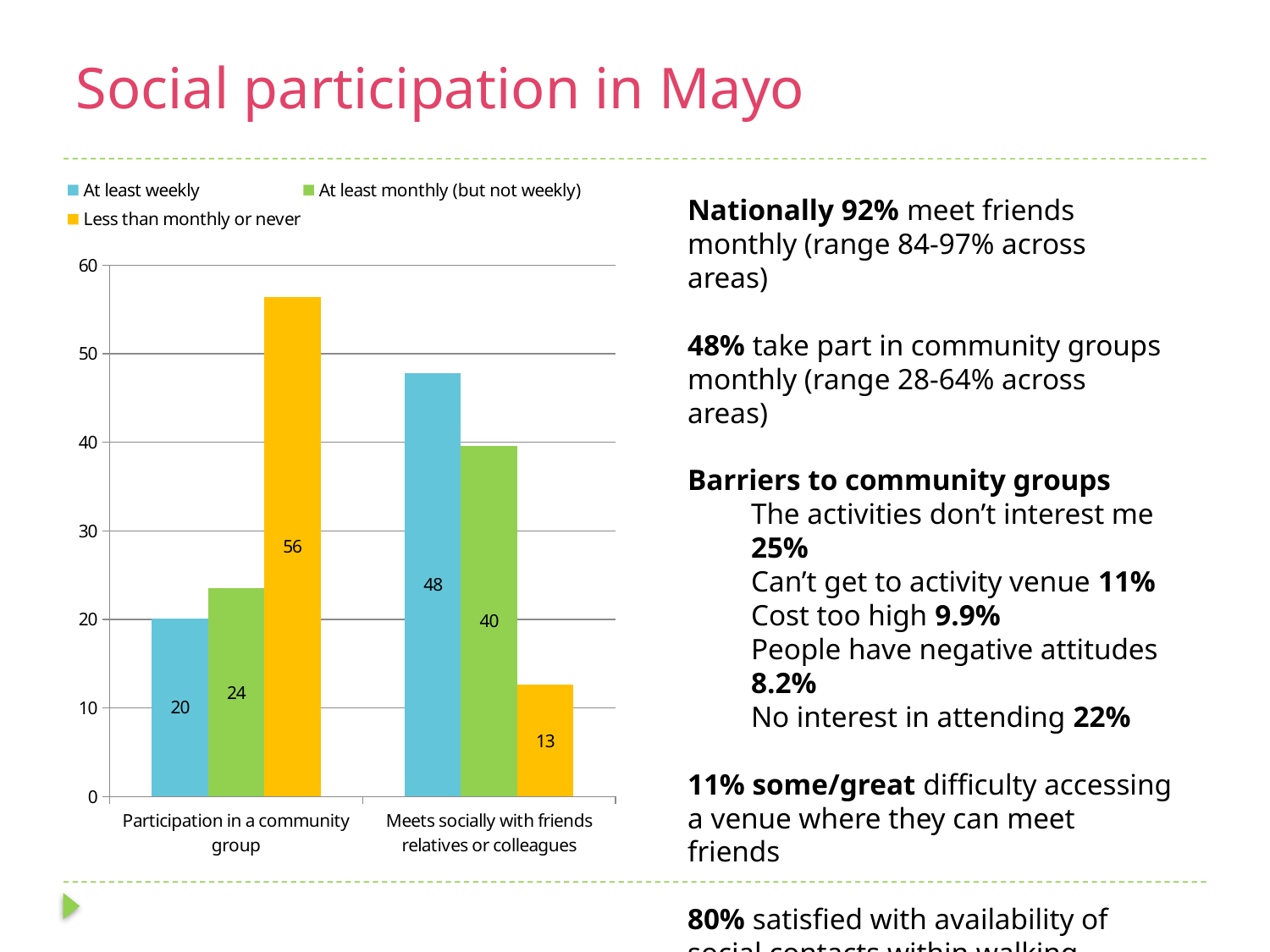
What is the value for "Less than monthly or never" in the "Meets socially with friends relatives or colleagues" category? 13 How many categories are shown on the x axis of the chart? 2 What is the value for "At least monthly (but not weekly)" in the "Participation in a community group" category? 24 How many series does the chart legend list? 3 What colour represents the "At least weekly" series in the chart? Blue What is the value for "At least weekly" in the "Participation in a community group" category? 20 Which series has the lowest value in the "Meets socially with friends relatives or colleagues" category? Less than monthly or never Which series has the highest value in the "Participation in a community group" category? Less than monthly or never What is the difference between the "Less than monthly or never" values for the two categories? 43 What kind of chart is shown on the slide? Bar chart Is the value for "Less than monthly or never" in the "Participation in a community group" category greater or less than 50? greater Which is larger: the "At least weekly" value for "Meets socially with friends relatives or colleagues" or for "Participation in a community group"? Meets socially with friends relatives or colleagues